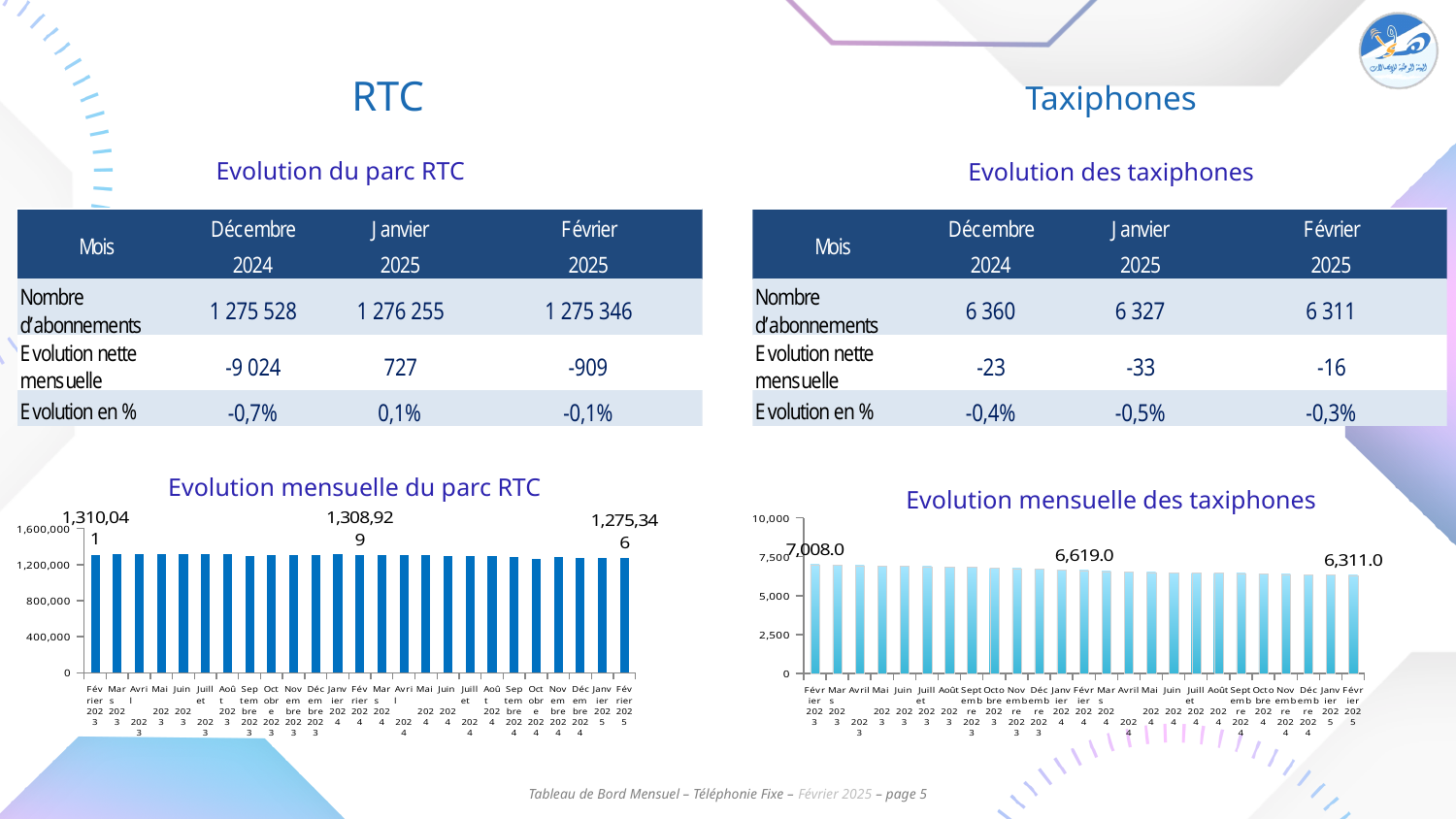
What kind of chart is 'Evolution mensuelle du parc RTC'? bar chart In the chart 'Evolution mensuelle du parc RTC', what is the difference between the labelled values for Février 2024 and Février 2025? 33,583 In the chart 'Evolution mensuelle des taxiphones', do the values generally rise or fall from Février 2023 to Février 2025? fall How many monthly bars are plotted in the chart 'Evolution mensuelle des taxiphones'? 25 In the chart 'Evolution mensuelle des taxiphones', what is the difference between the labelled values for Février 2023 and Février 2025? 697.0 In the chart 'Evolution mensuelle des taxiphones', which is larger: the value for Février 2023 or for Février 2025? Février 2023 In the chart 'Evolution mensuelle des taxiphones', what is the value labelled for Février 2025? 6,311.0 In the chart 'Evolution mensuelle des taxiphones', what is the value labelled for Février 2024? 6,619.0 In the chart 'Evolution mensuelle du parc RTC', is the value for Juin 2024 greater or less than 1,200,000? greater In the chart 'Evolution mensuelle du parc RTC', what is the value labelled for Février 2025? 1,275,346 In the chart 'Evolution mensuelle du parc RTC', what is the value labelled for Février 2023? 1,310,041 In the chart 'Evolution mensuelle des taxiphones', what is the value labelled for Février 2023? 7,008.0